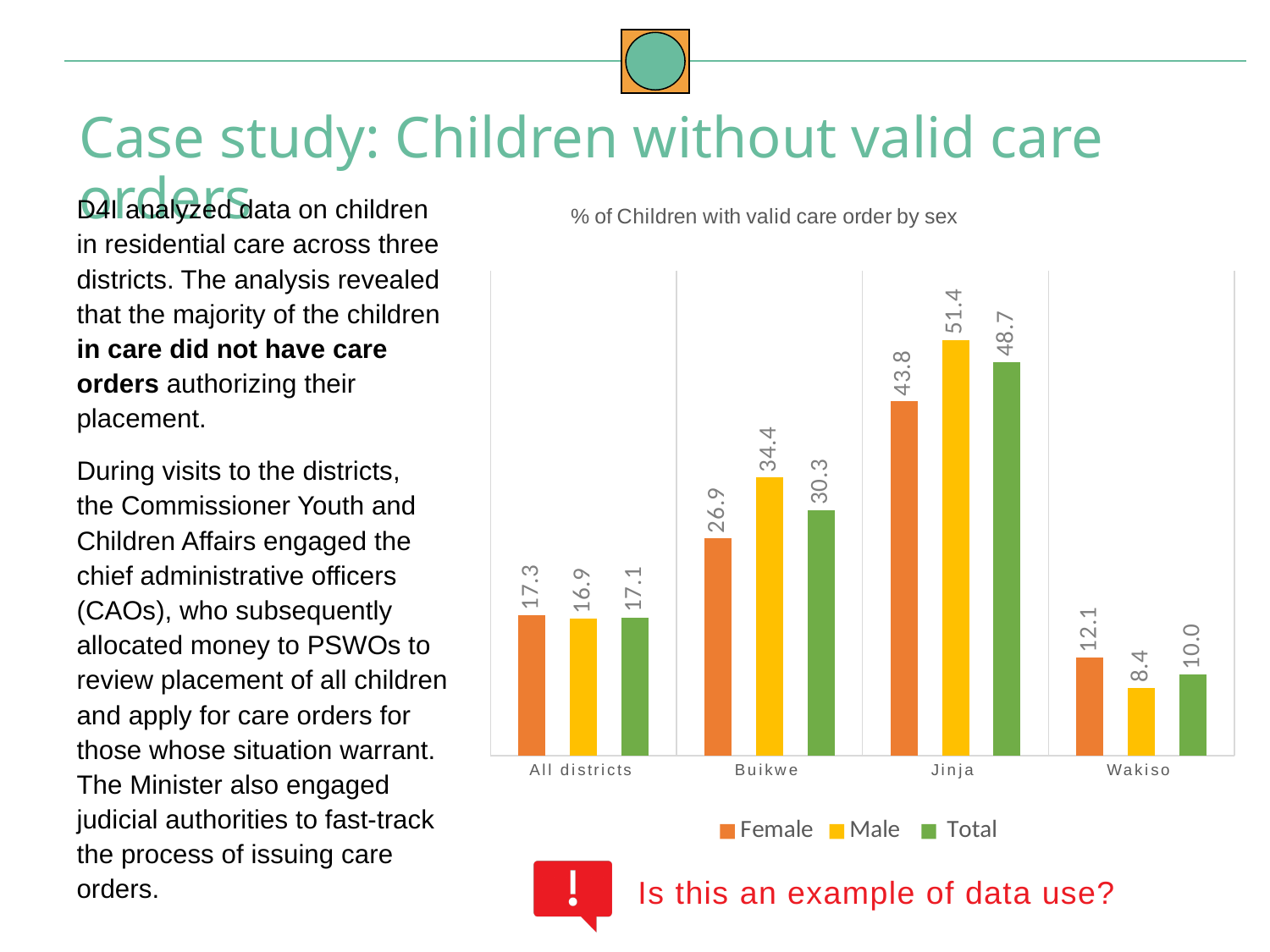
What kind of chart is shown on the slide? Bar chart How many categories are shown on the x axis? 4 What is the Male value for Wakiso? 8.4 What is the Male value for All districts? 16.9 Which is larger for Jinja, the Male value or the Female value? Male What is the Female value for Jinja? 43.8 How many series does the legend list? 3 Which category has the lowest Total value? Wakiso What is the title of the chart? % of Children with valid care order by sex What is the Total value for Buikwe? 30.3 Which district has the highest Male value? Jinja What is the difference between the Male and Female values for Buikwe? 7.5